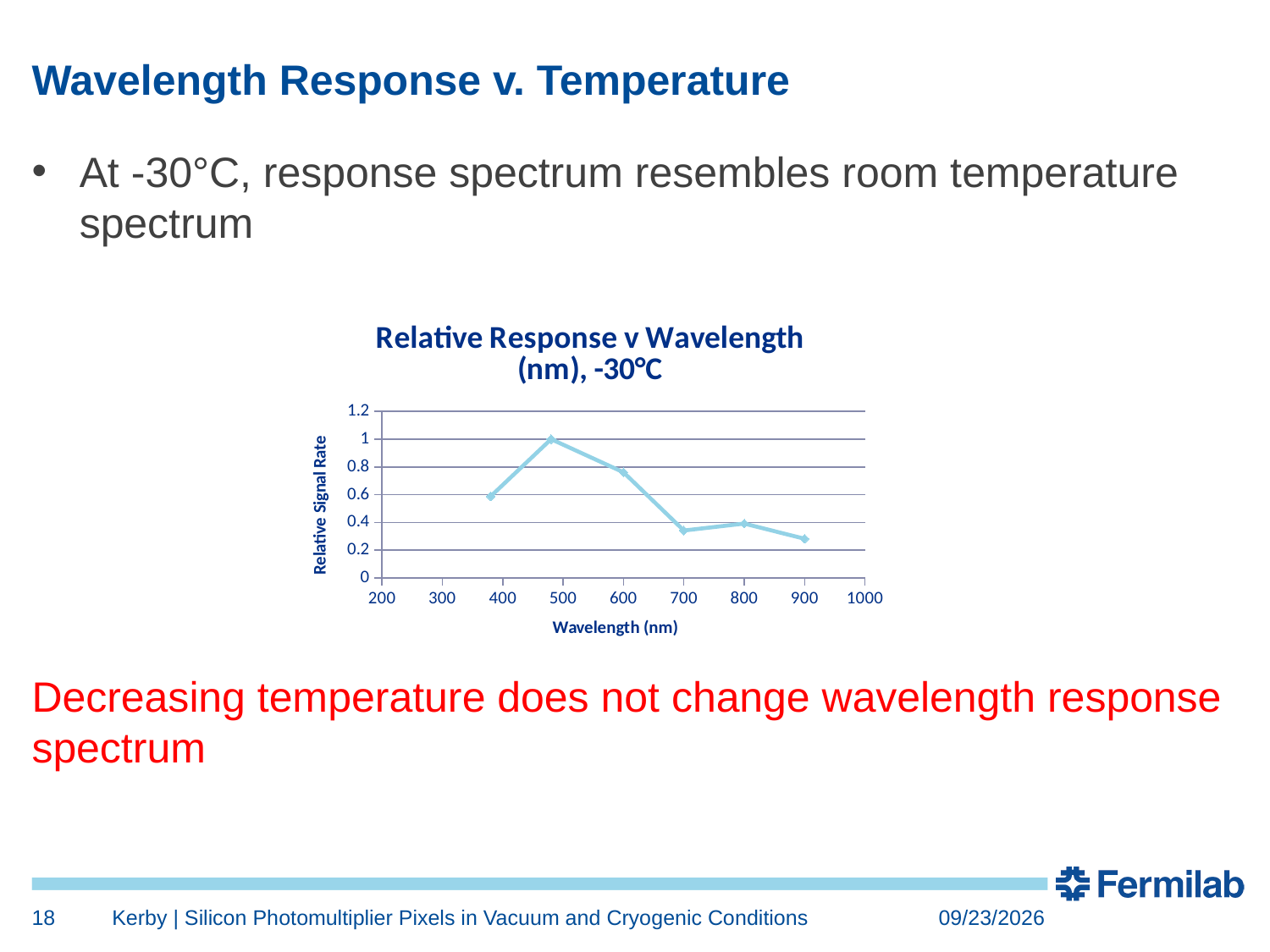
Is the relative signal rate at 600 nm greater or less than 0.6? greater Is the highest relative signal rate on the chart greater or less than 0.8? greater Is the relative signal rate at 900 nm greater or less than 0.4? less Does the relative signal rate rise or fall between 600 nm and 700 nm? fall How many data points are plotted on the line? 6 Which has the higher relative signal rate, 600 nm or 800 nm? 600 nm What is the label of the vertical axis? Relative Signal Rate What kind of chart is shown on the slide? line chart Does the relative signal rate rise or fall between the first and second plotted points? rise What is the title of the chart? Relative Response v Wavelength (nm), -30°C